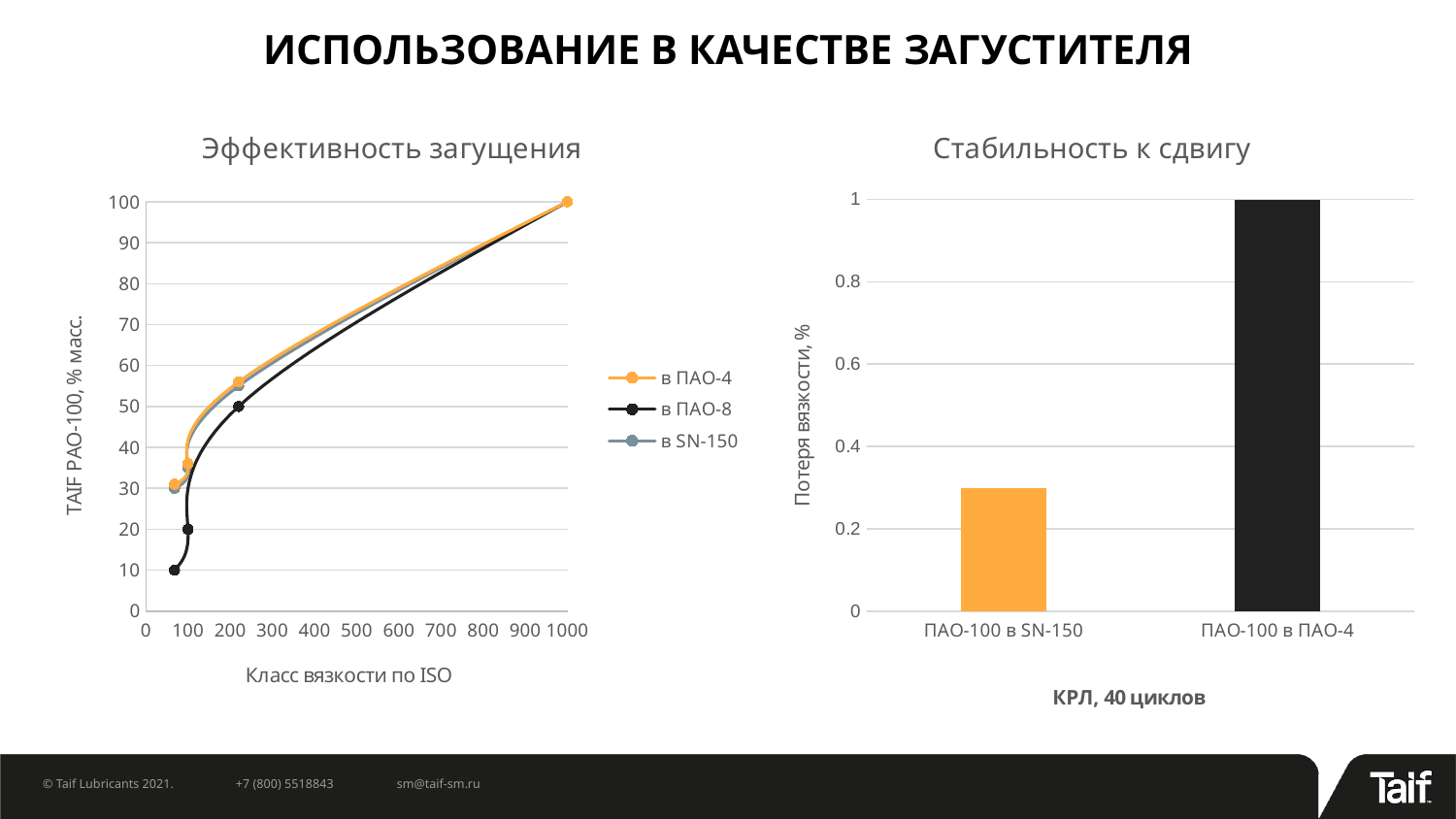
On the chart titled "Стабильность к сдвигу", is the value for ПАО-100 в SN-150 greater or less than 0.2? greater On the chart titled "Стабильность к сдвигу", how many categories are shown? 2 On the chart titled "Стабильность к сдвигу", which category has the lowest value? ПАО-100 в SN-150 On the chart titled "Стабильность к сдвигу", what is the value for ПАО-100 в ПАО-4? 1 What kind of chart is the one titled "Эффективность загущения"? line chart On the chart titled "Стабильность к сдвигу", which category has the highest value? ПАО-100 в ПАО-4 On the chart titled "Эффективность загущения", do the values rise or fall as the ISO viscosity class increases? rise On the chart titled "Эффективность загущения", what value do all three series reach at ISO viscosity class 1000? 100 What kind of chart is the one titled "Стабильность к сдвигу"? bar chart On the chart titled "Стабильность к сдвигу", is the value for ПАО-100 в SN-150 greater or less than 0.4? less On the chart titled "Эффективность загущения", what is the y-axis label? TAIF PAO-100, % масс. On the chart titled "Эффективность загущения", how many series does the legend list? 3